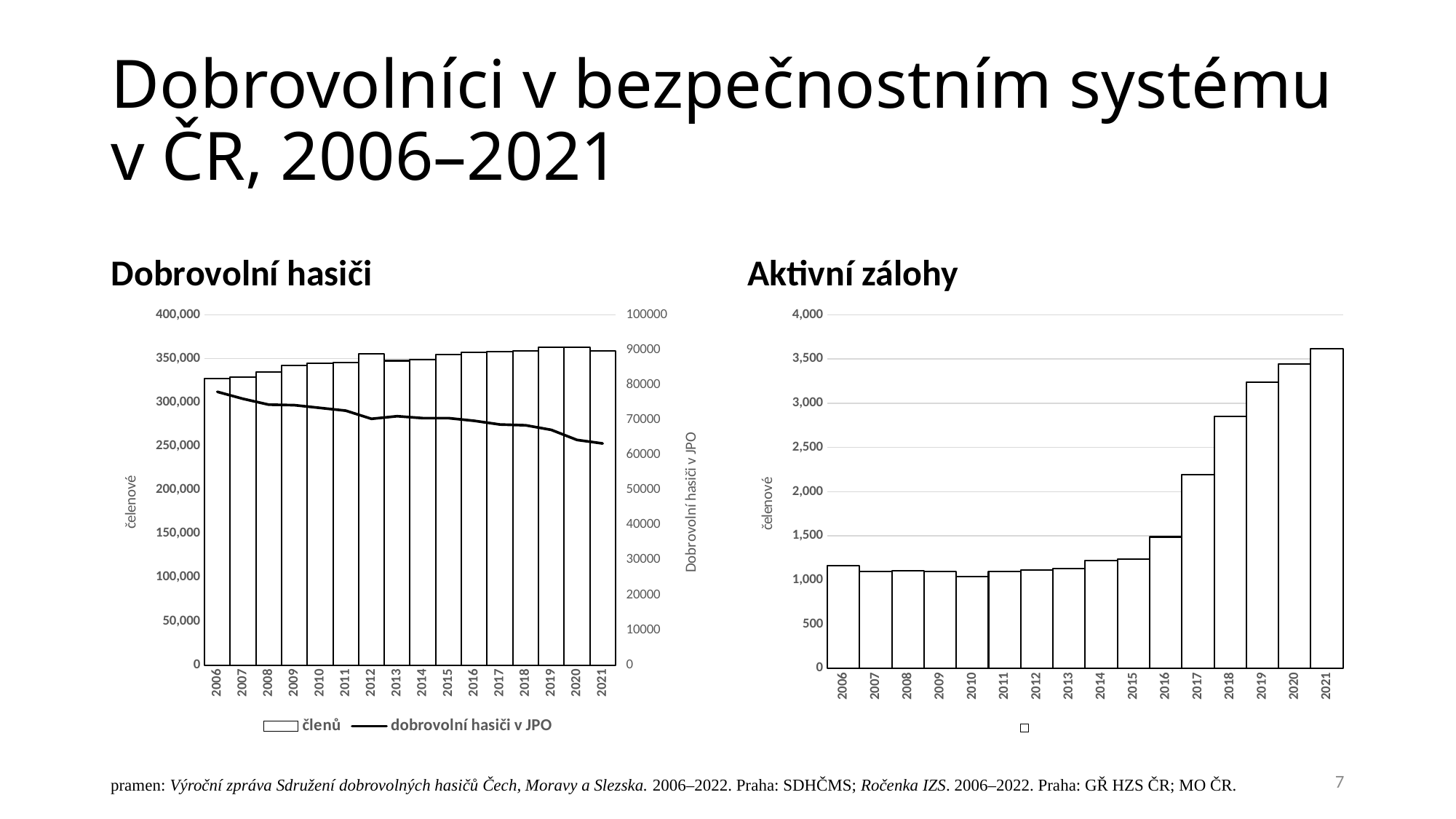
In the 'Aktivní zálohy' chart, which year has the lowest value? 2010 How many years are shown on the x axis of the 'Aktivní zálohy' chart? 16 In the 'Dobrovolní hasiči' chart, which year has the lowest value for 'členů'? 2006 In the 'Dobrovolní hasiči' chart, is the 'členů' value for 2006 greater or less than 300,000? greater In the 'Aktivní zálohy' chart, is the value for 2021 greater or less than 3,500? greater In the 'Aktivní zálohy' chart, is the value for 2017 larger than the value for 2016? yes In the 'Dobrovolní hasiči' chart, is the 'dobrovolní hasiči v JPO' value for 2021 greater or less than 70000? less How many series does the legend of the 'Dobrovolní hasiči' chart list? 2 What kind of chart is the 'Aktivní zálohy' chart? bar chart In the 'Dobrovolní hasiči' chart, does the 'dobrovolní hasiči v JPO' line rise or fall from 2006 to 2021? fall In the 'Aktivní zálohy' chart, which year has the highest value? 2021